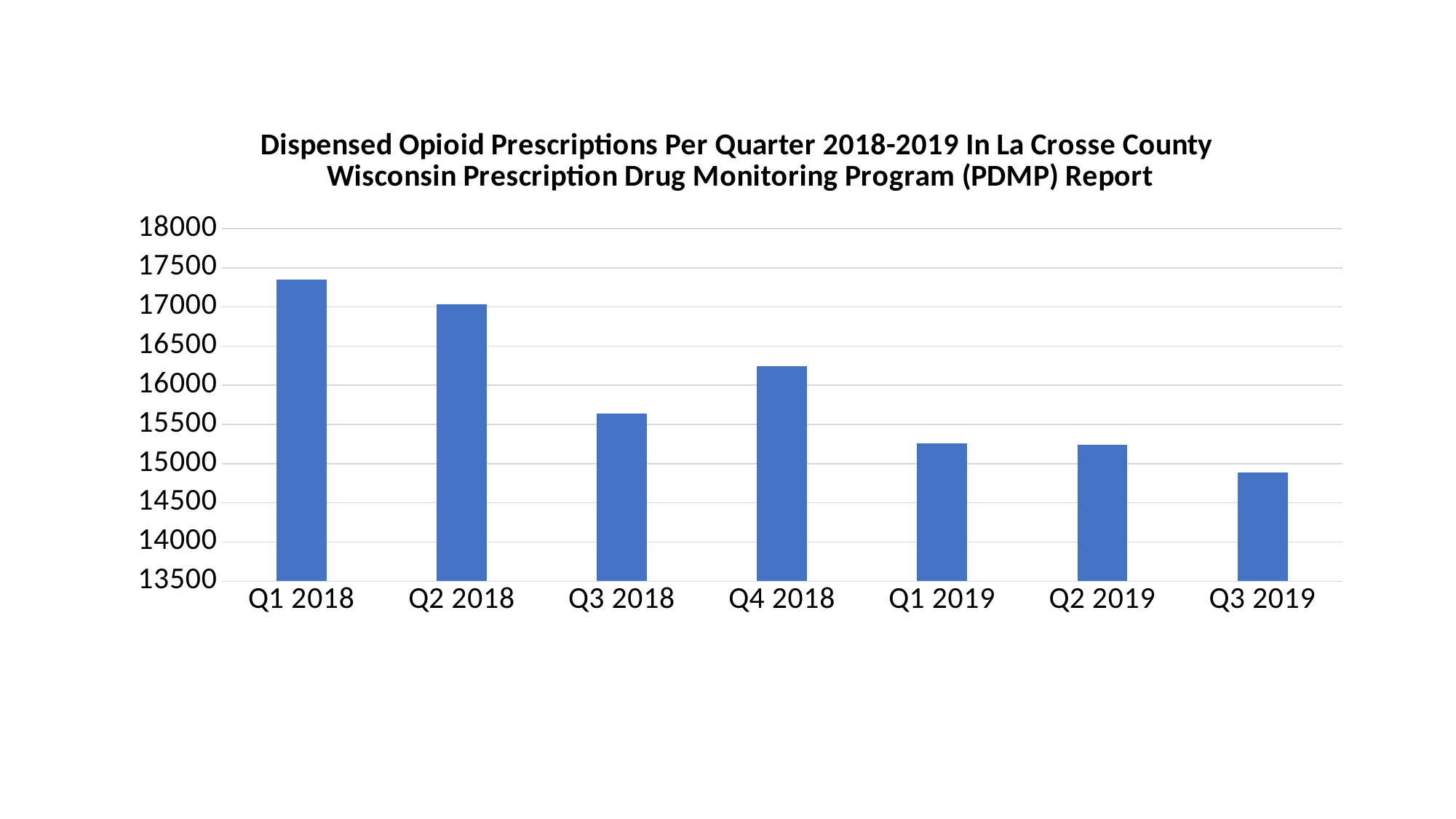
Which quarter has the highest number of dispensed opioid prescriptions? Q1 2018 Is the value for Q3 2018 greater or less than 16000? less Which is larger, the value for Q3 2018 or the value for Q4 2018? Q4 2018 Which is larger, the value for Q2 2018 or the value for Q1 2019? Q2 2018 Is the value for Q3 2019 greater or less than 15000? less Is the value for Q1 2018 greater or less than 17000? greater What kind of chart is shown on the slide? bar chart Overall, do the values rise or fall from Q1 2018 to Q3 2019? fall How many quarters are plotted on the chart? 7 Which county does the chart title say the data is for? La Crosse County Which quarter has the lowest number of dispensed opioid prescriptions? Q3 2019